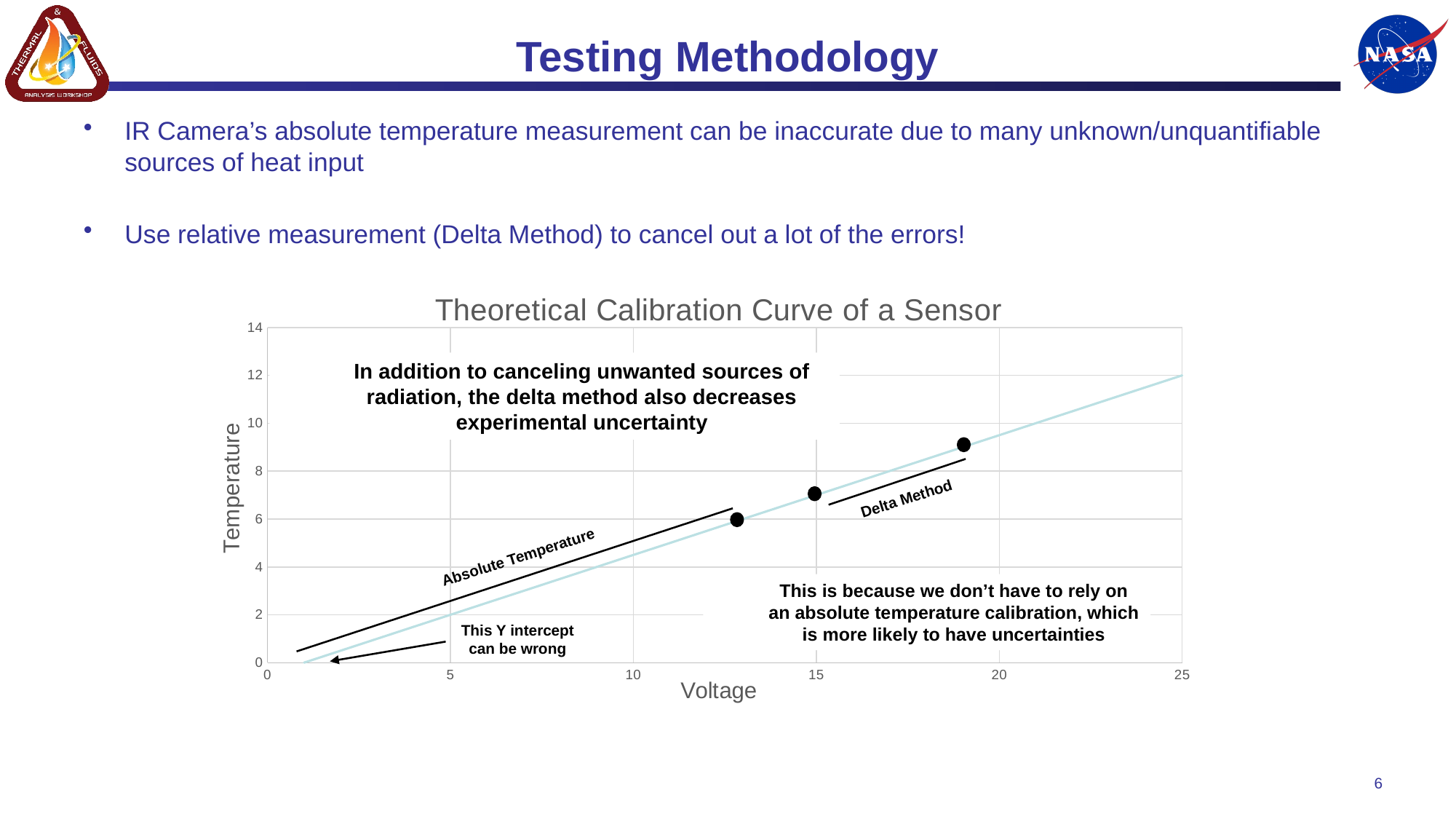
Does the temperature rise or fall as voltage increases along the x axis? rise What is the title of the chart on the slide? Theoretical Calibration Curve of a Sensor Which plotted point has the lowest temperature: the leftmost, middle, or rightmost? leftmost What kind of chart is the "Theoretical Calibration Curve of a Sensor"? line chart Which plotted point has the highest temperature: the leftmost, middle, or rightmost? rightmost Is the voltage of the middle plotted point greater or less than 10? greater Is the temperature of the leftmost plotted point greater or less than 8? less What is the label of the x axis of the chart? Voltage Which has the higher temperature, the leftmost plotted point or the rightmost plotted point? rightmost How many black data points are plotted on the chart? 3 Is the temperature of the rightmost plotted point greater or less than 8? greater What is the highest value shown on the Temperature axis? 14